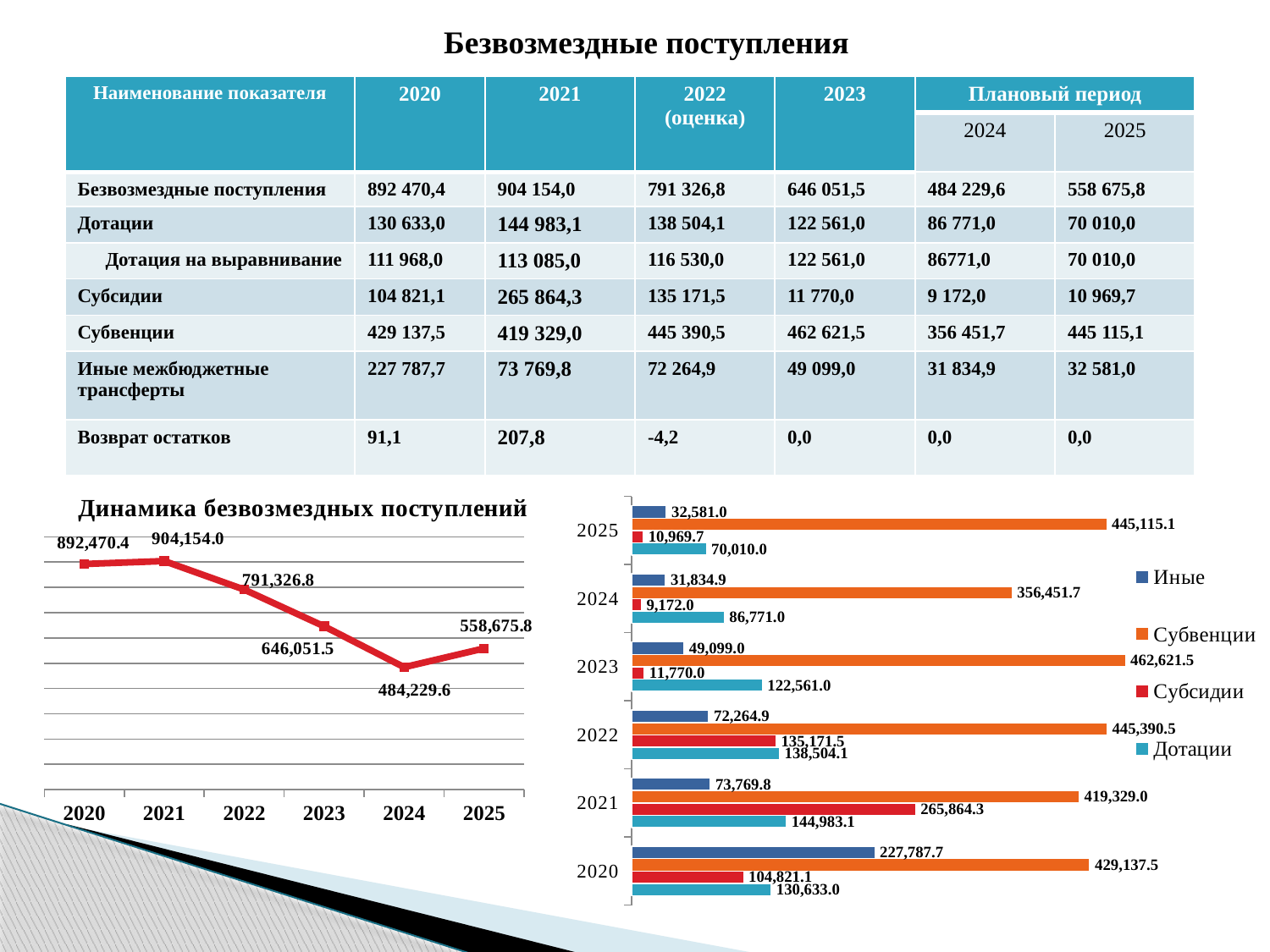
In the chart titled "Динамика безвозмездных поступлений", which year has the highest value? 2021 In the chart titled "Динамика безвозмездных поступлений", do the values rise or fall from 2021 to 2024? fall In the chart titled "Динамика безвозмездных поступлений", which year has the lowest value? 2024 In the chart titled "Динамика безвозмездных поступлений", what is the value for 2023? 646,051.5 In the chart titled "Динамика безвозмездных поступлений", what is the difference between the values for 2021 and 2020? 11,683.6 What type of chart is the chart on the right side of the slide? bar chart In the bar chart on the right side of the slide, in which year is the value of Субсидии the lowest? 2024 In the bar chart on the right side of the slide, how many series does the legend list? 4 In the bar chart on the right side of the slide, what is the value of Субвенции for 2024? 356,451.7 What type of chart is the chart titled "Динамика безвозмездных поступлений"? line chart In the chart titled "Динамика безвозмездных поступлений", how many years are plotted on the x axis? 6 In the bar chart on the right side of the slide, which is larger for 2020: Иные or Дотации? Иные